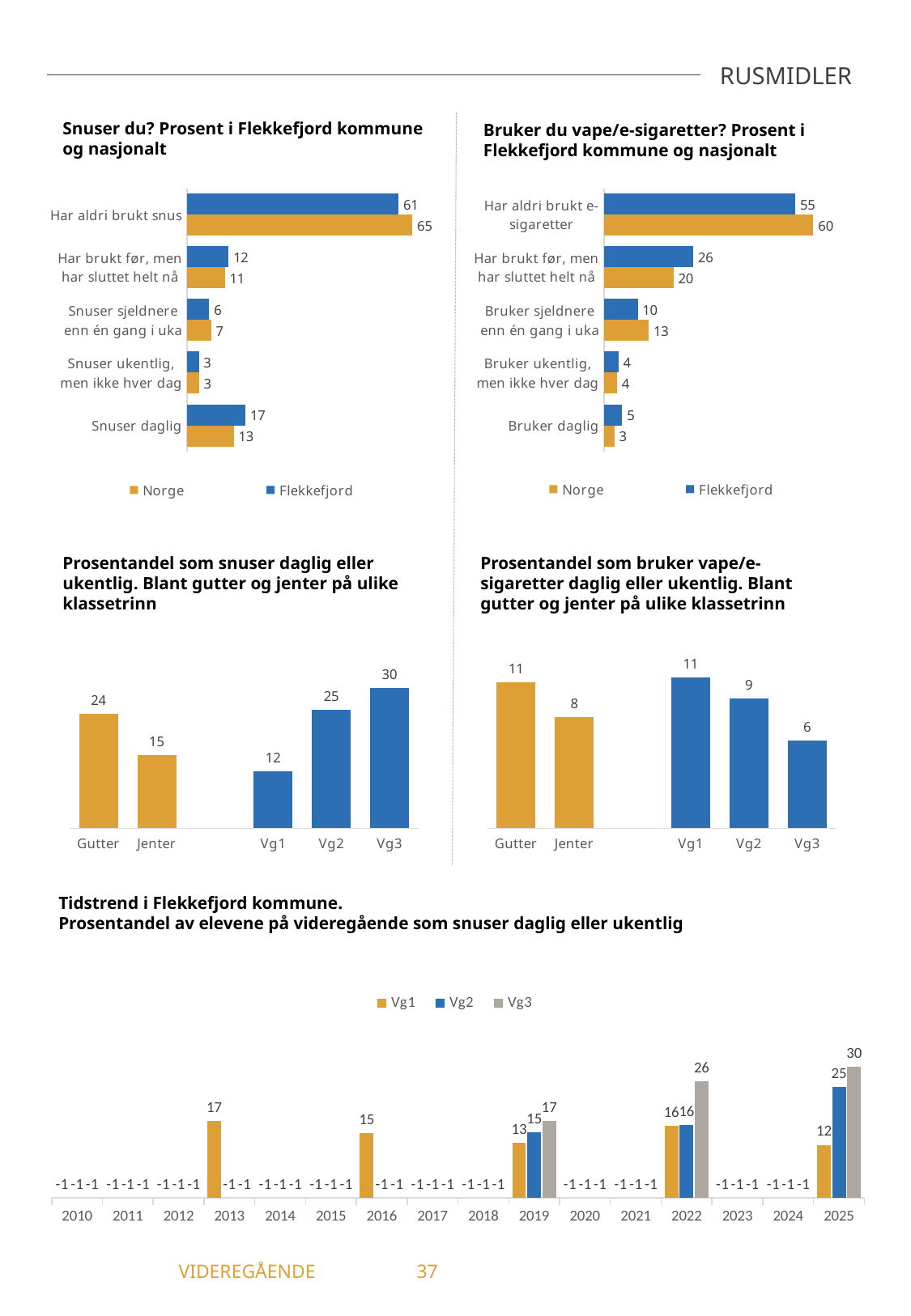
In the chart 'Prosentandel som snuser daglig eller ukentlig. Blant gutter og jenter på ulike klassetrinn', which category has the highest value? Vg3 What kind of chart is 'Tidstrend i Flekkefjord kommune'? Bar chart In the chart 'Prosentandel som bruker vape/e-sigaretter daglig eller ukentlig. Blant gutter og jenter på ulike klassetrinn', which category has the lowest value? Vg3 In the chart 'Prosentandel som bruker vape/e-sigaretter daglig eller ukentlig. Blant gutter og jenter på ulike klassetrinn', what is the difference between Gutter and Jenter? 3 In the chart 'Bruker du vape/e-sigaretter? Prosent i Flekkefjord kommune og nasjonalt', which is larger for 'Bruker daglig': Norge or Flekkefjord? Flekkefjord In the chart 'Snuser du? Prosent i Flekkefjord kommune og nasjonalt', what is the difference between Norge and Flekkefjord for 'Har aldri brukt snus'? 4 In the chart 'Tidstrend i Flekkefjord kommune', what is the value for Vg3 in 2025? 30 In the chart 'Snuser du? Prosent i Flekkefjord kommune og nasjonalt', what is the value for Flekkefjord for 'Snuser daglig'? 17 How many series does the legend list in the chart 'Bruker du vape/e-sigaretter? Prosent i Flekkefjord kommune og nasjonalt'? 2 In the chart 'Prosentandel som snuser daglig eller ukentlig. Blant gutter og jenter på ulike klassetrinn', what is the value for Jenter? 15 In the chart 'Bruker du vape/e-sigaretter? Prosent i Flekkefjord kommune og nasjonalt', what is the value for Norge for 'Har brukt før, men har sluttet helt nå'? 20 In the chart 'Tidstrend i Flekkefjord kommune', what is the value for Vg1 in 2013? 17